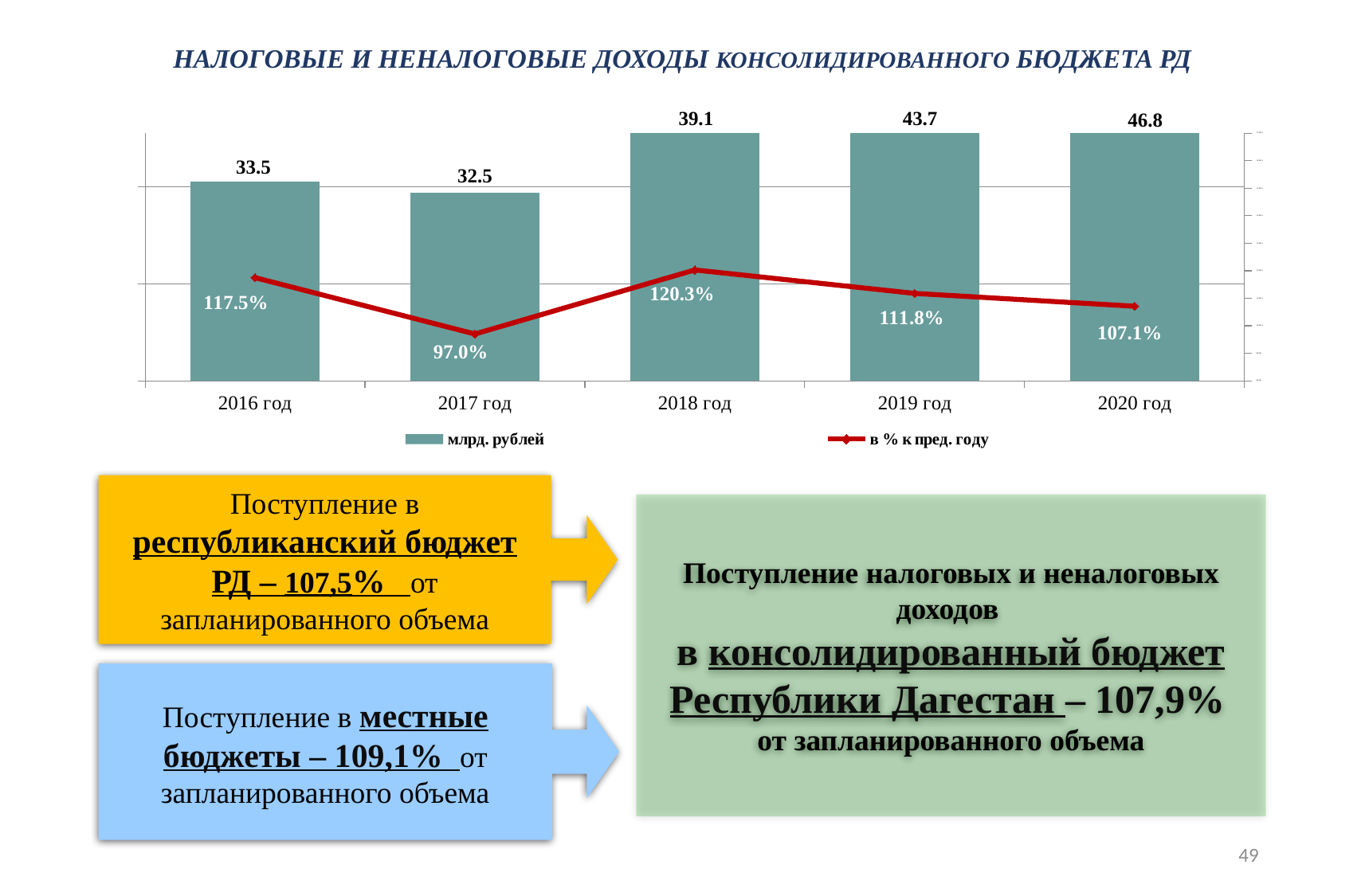
What is the title of the chart on the slide? НАЛОГОВЫЕ И НЕНАЛОГОВЫЕ ДОХОДЫ КОНСОЛИДИРОВАННОГО БЮДЖЕТА РД Which is larger, the млрд. рублей value for 2019 год or for 2018 год? 2019 год How many years are shown on the x axis of the chart? 5 What is the value in млрд. рублей for 2018 год? 39.1 How many series does the chart legend list? 2 Do the млрд. рублей values rise or fall from 2017 год to 2020 год? rise What is the value in млрд. рублей for 2020 год? 46.8 What is the difference in млрд. рублей between 2020 год and 2016 год? 13.3 What is the value of the 'в % к пред. году' series for 2017 год? 97.0% Which year has the highest value of the 'в % к пред. году' series? 2018 год Which year has the lowest value in млрд. рублей? 2017 год Which year has the highest value in млрд. рублей? 2020 год